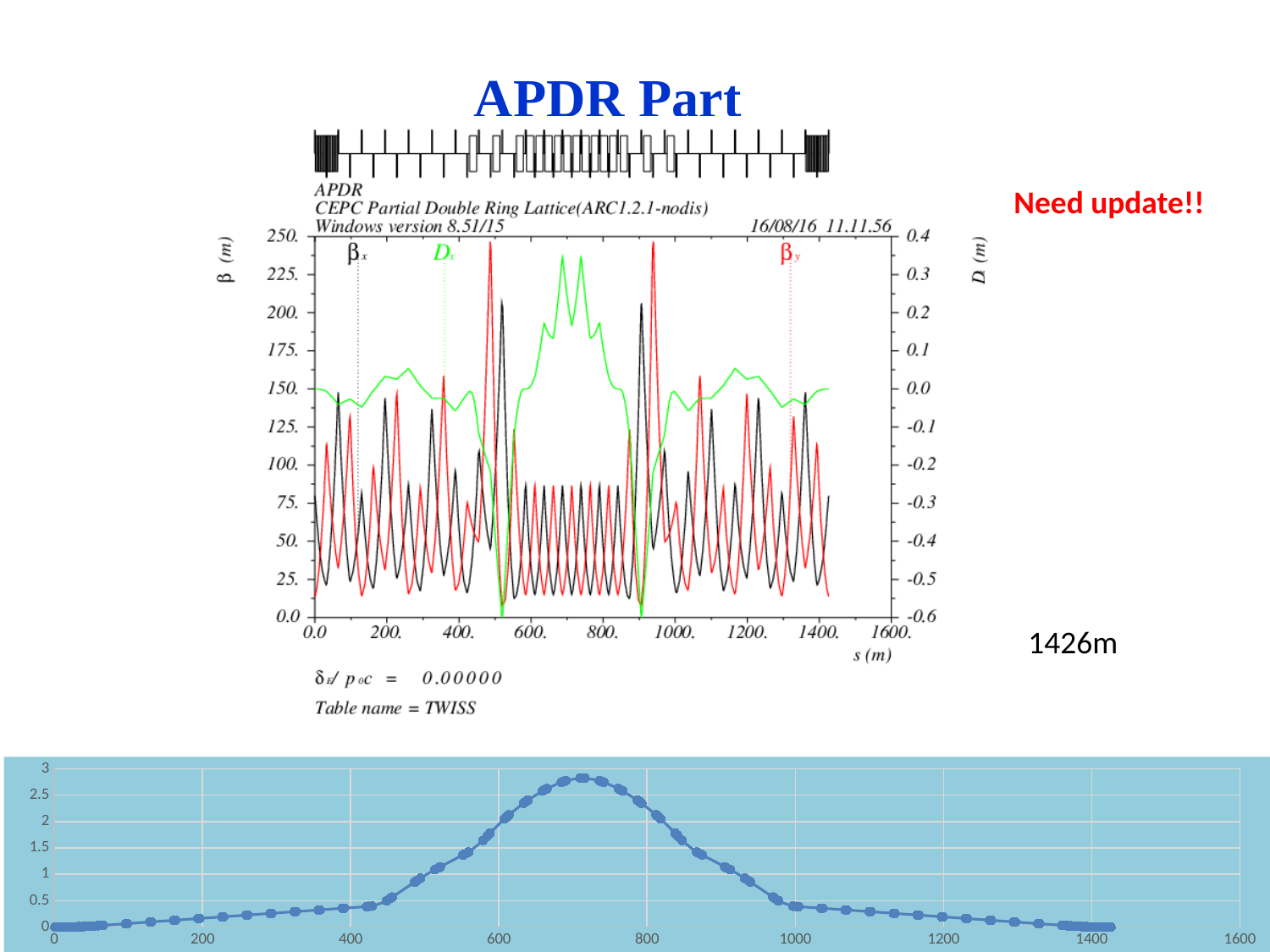
In the top chart, what is the maximum value shown on the left β (m) axis? 250 What kind of chart is the bottom chart? line chart In the top chart, is the highest peak of Dx greater or less than 0.3? greater In the top chart, what is the title printed above the plot? CEPC Partial Double Ring Lattice(ARC1.2.1-nodis) In the top chart, how many series are labelled in the legend? 3 In the bottom chart, is the peak value greater or less than 2.5? greater In the bottom chart, is the value at x = 200 greater or less than 0.5? less What kind of chart is the top chart? line chart In the bottom chart, do the values rise or fall between x = 800 and x = 1000? fall In the top chart, what are the three series labelled in the legend? βx, Dx, βy